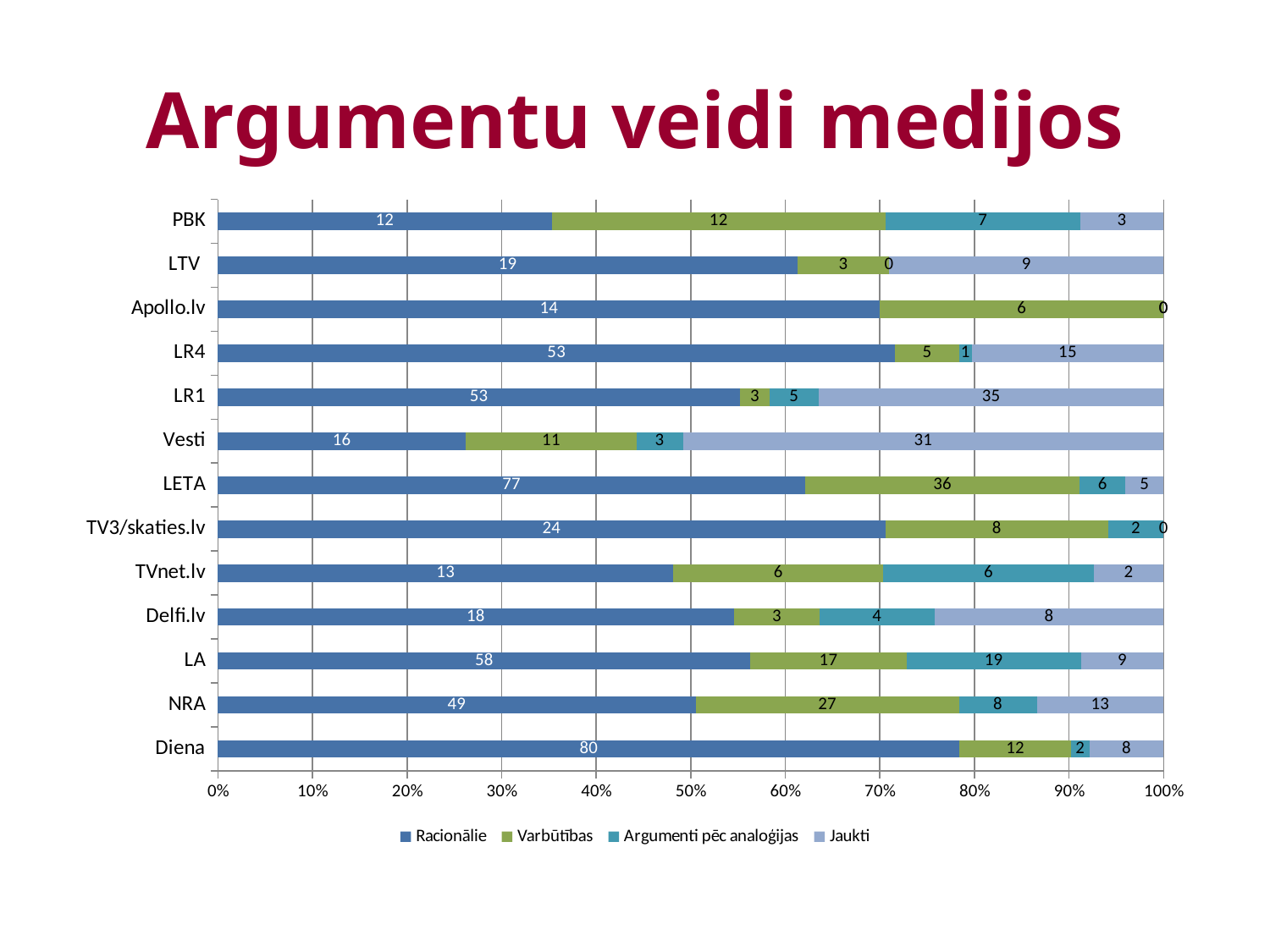
How many series does the legend list? 4 What is the total of all four values for LA? 103 Which is larger, the Racionālie value for LETA or for LA? LETA Which media outlet has the highest Racionālie value? Diena What is the Argumenti pēc analoģijas value for LA? 19 What is the Racionālie value for Diena? 80 What is the Jaukti value for LR1? 35 Which media outlet has the highest Jaukti value? LR1 What is the difference between the Varbūtības values for NRA and Diena? 15 What is the Varbūtības value for LETA? 36 How many media outlets are shown on the chart? 13 What kind of chart is shown on the slide? Stacked bar chart